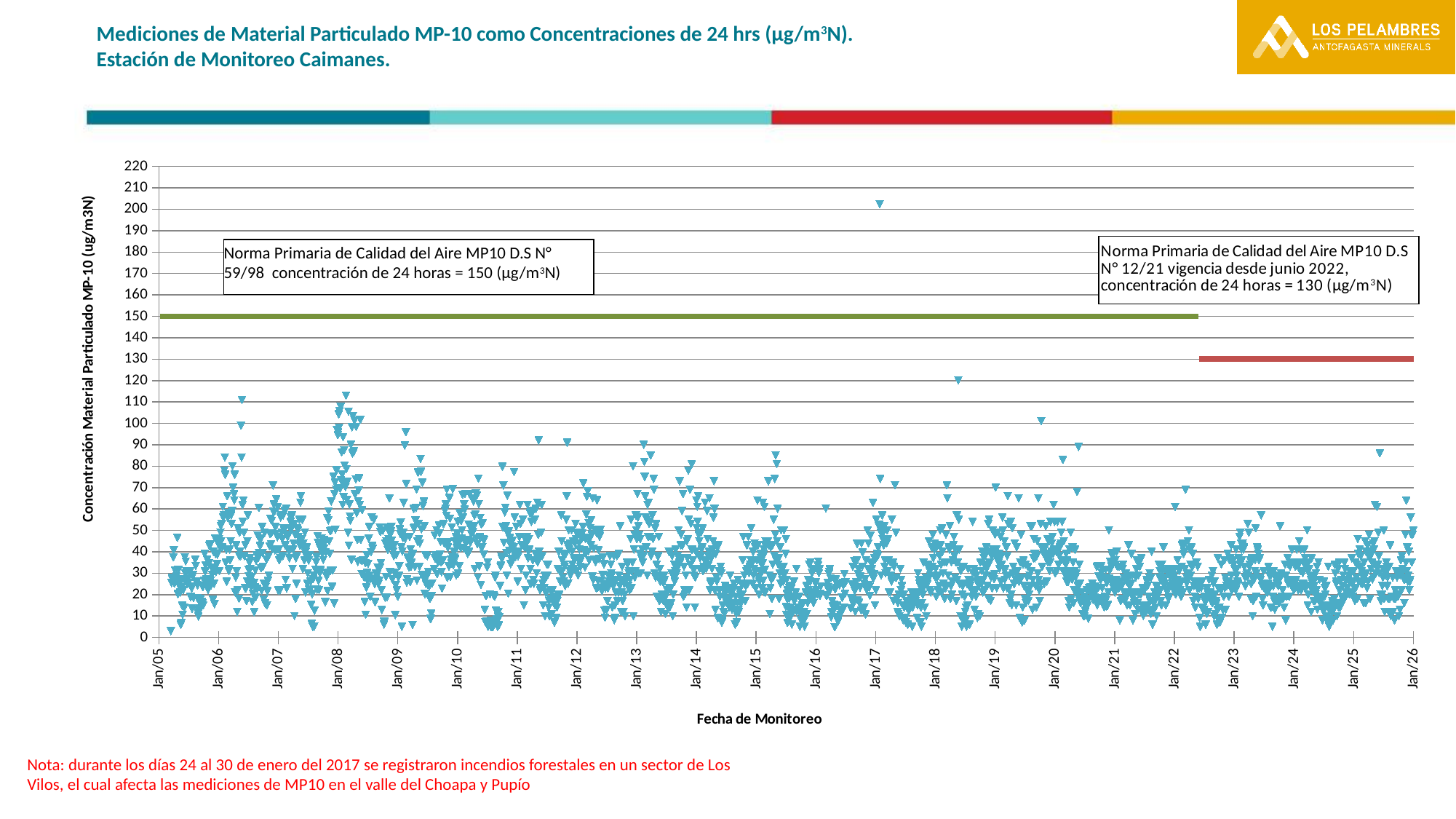
Is the highest measurement in 2025 greater or less than 80? greater What 24-hour concentration does the red reference line (Norma Primaria D.S N° 12/21) mark? 130 (µg/m³N) In which year does the highest measurement on the chart occur? 2017 What 24-hour concentration does the green reference line (Norma Primaria D.S N° 59/98) mark? 150 (µg/m³N) Which of the two reference lines is higher, the green one or the red one? the green one How many measurements exceed the 150 reference line? 1 What is the highest value shown on the y axis? 220 What is the difference between the two reference line values, 150 and 130? 20 What kind of chart is shown on the slide? scatter chart Is the highest measurement in 2008 greater or less than 100? greater What is the label of the x axis? Fecha de Monitoreo